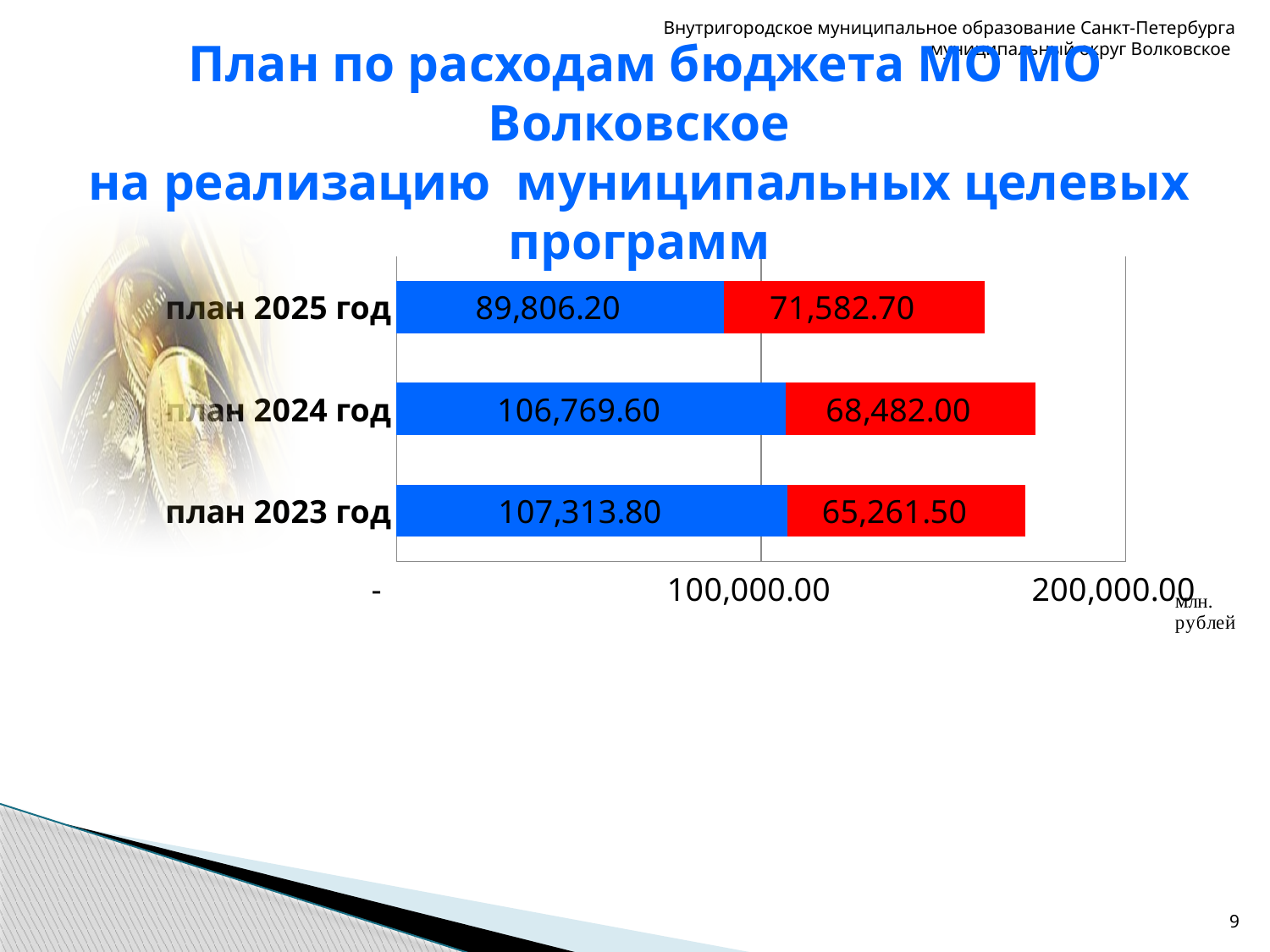
What is the value of the blue segment for план 2025 год? 89,806.20 What is the value of the blue segment for план 2023 год? 107,313.80 Which year has the highest value for the red segment? план 2025 год What is the difference between the red segment values for план 2025 год and план 2023 год? 6,321.20 What is the value of the red segment for план 2025 год? 71,582.70 What is the total of the stacked bar for план 2025 год? 161,388.90 What is the total of the stacked bar for план 2024 год? 175,251.60 What type of chart is shown on the slide? Stacked bar chart Which year has the lowest value for the blue segment? план 2025 год How many years (categories) are shown in the chart? 3 What is the value of the red segment for план 2024 год? 68,482.00 Is the blue segment value for план 2024 год larger or smaller than the blue segment value for план 2025 год? larger